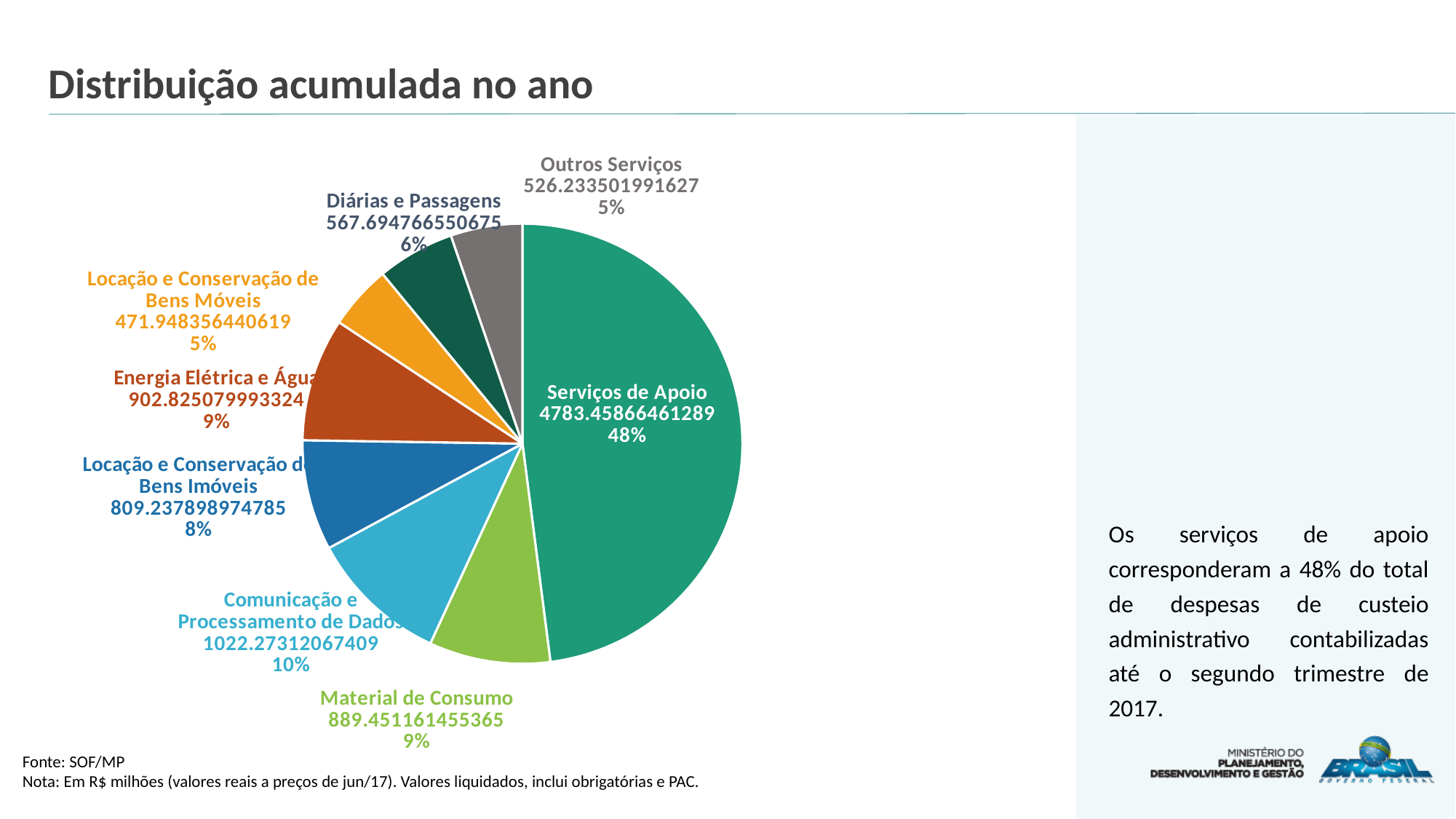
Which is larger, the value for Comunicação e Processamento de Dados or the value for Locação e Conservação de Bens Imóveis? Comunicação e Processamento de Dados What kind of chart is shown on the slide? Pie chart What is the title of the chart on the slide? Distribuição acumulada no ano Which category has the smallest slice of the pie? Locação e Conservação de Bens Móveis What share of the pie does Locação e Conservação de Bens Imóveis represent? 8% How many slices does the pie chart have? 8 What is the value shown for Comunicação e Processamento de Dados? 1022.27312067409 What is the value shown for Serviços de Apoio? 4783.45866461289 Which category has the largest slice of the pie? Serviços de Apoio By how many percentage points does the share of Serviços de Apoio exceed the share of Comunicação e Processamento de Dados? 38 percentage points What share of the pie does Serviços de Apoio represent? 48% What is the value shown for Energia Elétrica e Água? 902.825079993324